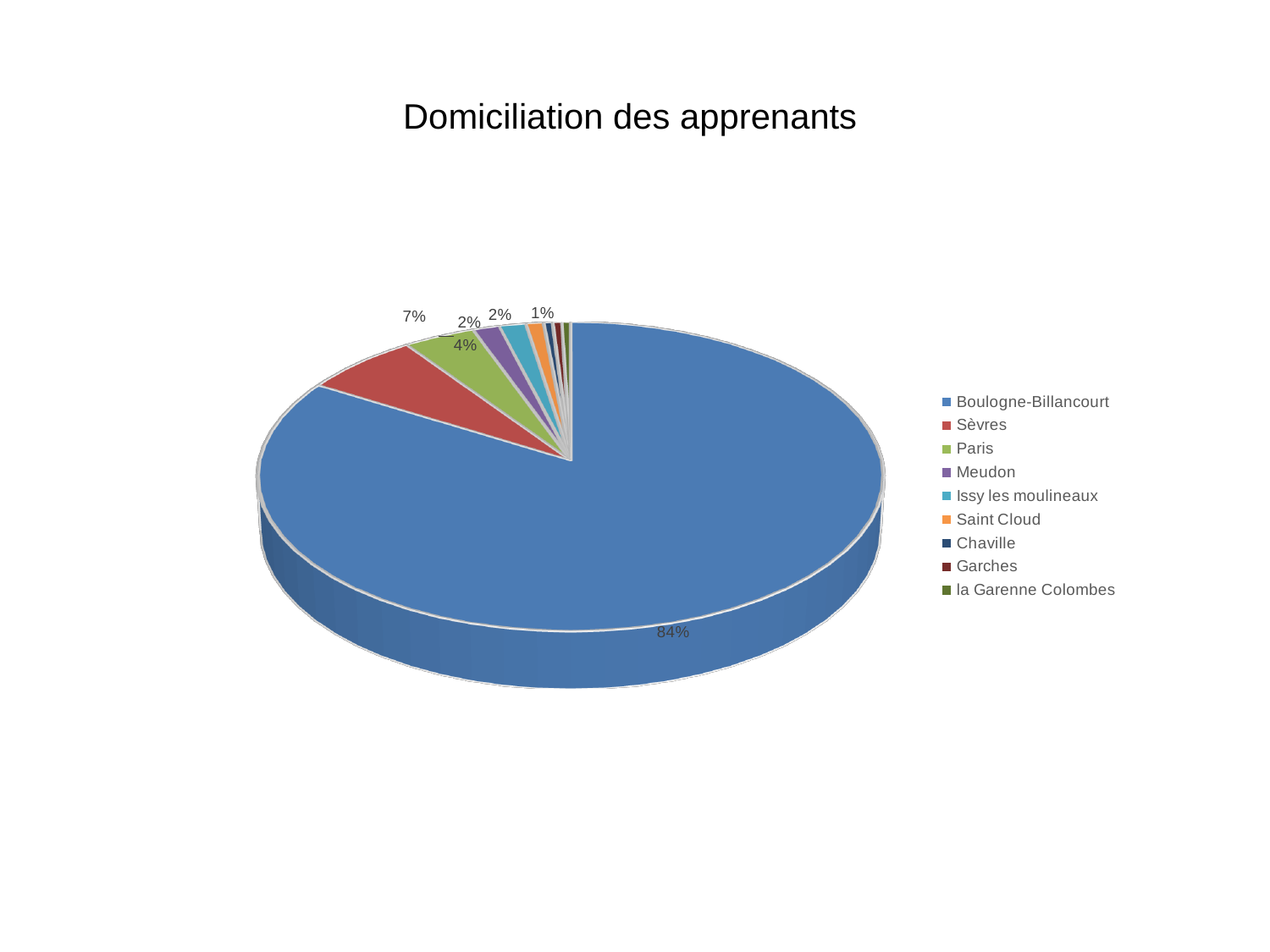
Is the slice for Boulogne-Billancourt larger than the slice for Paris? Yes What is the value shown for Sèvres? 7% What is the difference in percentage points between Sèvres and Paris? 3 What is the title of the chart? Domiciliation des apprenants Which category is shown in red in the legend? Sèvres What kind of chart is shown on the slide? Pie chart What share of the pie does Boulogne-Billancourt represent? 84% How many categories does the legend list? 9 Which is larger, the slice for Sèvres or the slice for Paris? Sèvres Which category has the largest slice of the pie? Boulogne-Billancourt What is the difference in percentage points between Boulogne-Billancourt and Sèvres? 77 What is the value shown for Paris? 4%